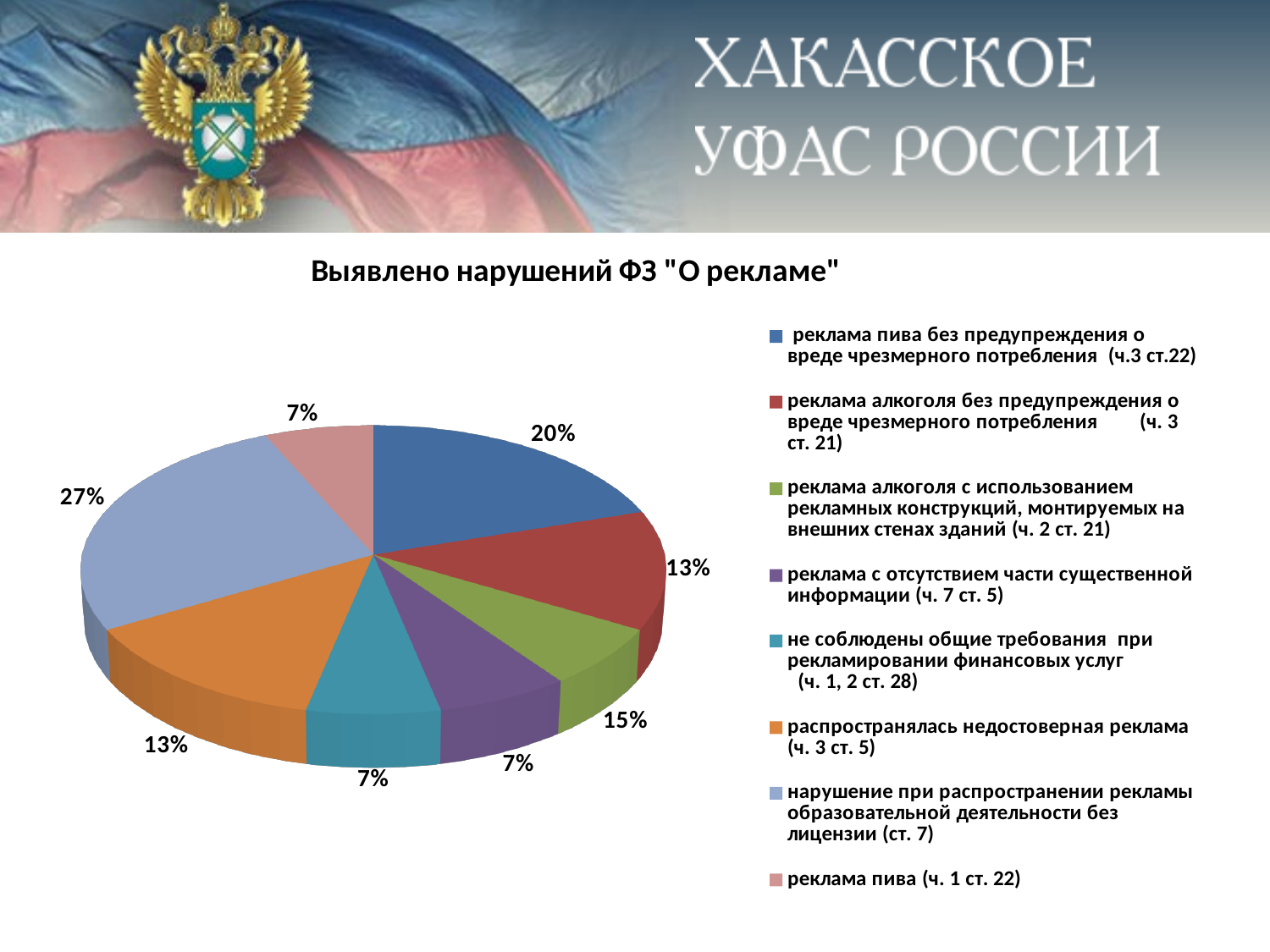
What share of the pie is "реклама алкоголя с использованием рекламных конструкций, монтируемых на внешних стенах зданий (ч. 2 ст. 21)"? 15% What share of the pie is "распространялась недостоверная реклама (ч. 3 ст. 5)"? 13% Which category has the largest share of the pie? нарушение при распространении рекламы образовательной деятельности без лицензии (ст. 7) What kind of chart is shown on the slide? pie chart How many slices are labelled 7%? 3 What share of the pie is "нарушение при распространении рекламы образовательной деятельности без лицензии (ст. 7)"? 27% Which is larger: the share for "реклама алкоголя без предупреждения о вреде чрезмерного потребления (ч. 3 ст. 21)" or the share for "реклама пива без предупреждения о вреде чрезмерного потребления (ч.3 ст.22)"? реклама пива без предупреждения о вреде чрезмерного потребления (ч.3 ст.22) How many slices does the pie chart have? 8 What is the title of the chart? Выявлено нарушений ФЗ "О рекламе" What is the difference in percentage points between the largest slice (27%) and the slice for "реклама пива без предупреждения о вреде чрезмерного потребления (ч.3 ст.22)"? 7